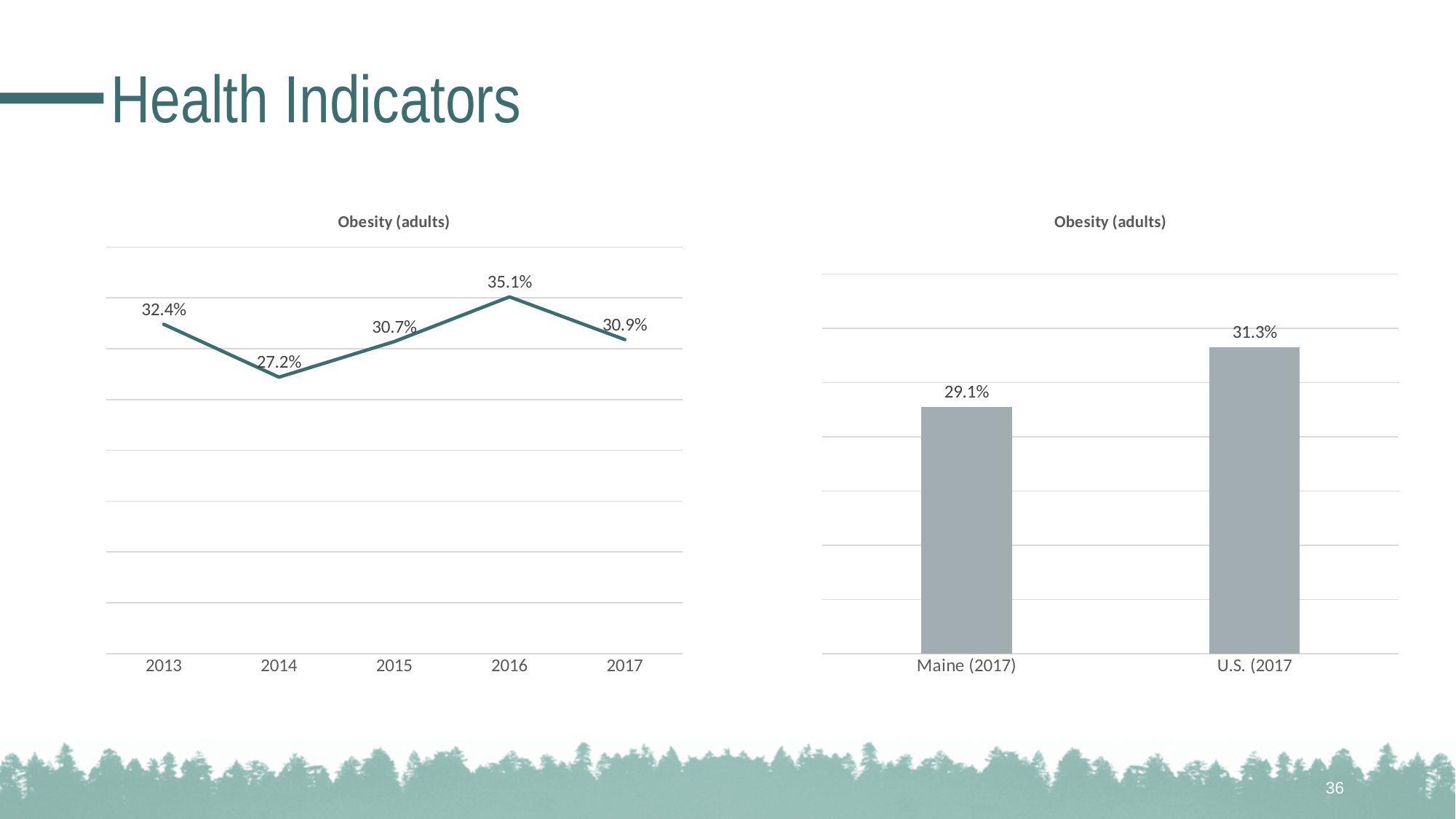
In the left chart (Obesity (adults) line chart), does the value rise or fall from 2016 to 2017? Fall In the right chart (Obesity (adults) bar chart), which is larger, Maine (2017) or U.S. (2017)? U.S. (2017) In the left chart (Obesity (adults) line chart), what is the value for 2016? 35.1% What kind of chart is the left chart on the slide? Line chart In the left chart (Obesity (adults) line chart), which year has the lowest value? 2014 In the left chart (Obesity (adults) line chart), what is the difference between the 2016 and 2014 values? 7.9% In the right chart (Obesity (adults) bar chart), what is the difference between the U.S. (2017) and Maine (2017) values? 2.2% In the left chart (Obesity (adults) line chart), how many years are plotted on the x axis? 5 In the left chart (Obesity (adults) line chart), what is the value for 2013? 32.4% In the left chart (Obesity (adults) line chart), which year has the highest value? 2016 What kind of chart is the right chart on the slide? Bar chart In the right chart (Obesity (adults) bar chart), what is the value for Maine (2017)? 29.1%